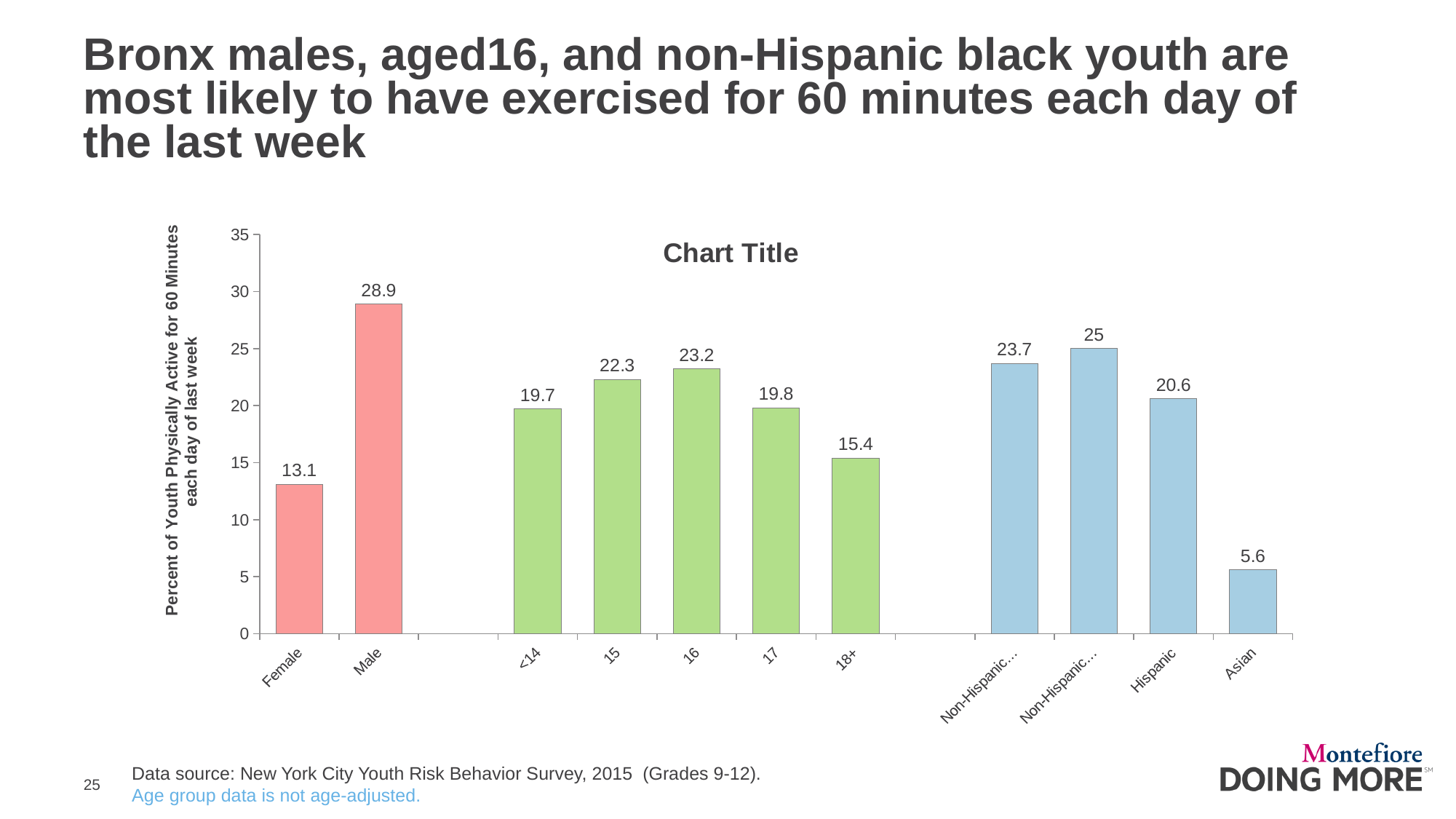
What is the value for Male? 28.9 What is the value for Female? 13.1 What is the value for the 16 age group? 23.2 How many bars are plotted in the chart? 11 What is the label on the vertical axis? Percent of Youth Physically Active for 60 Minutes each day of last week What is the value for Asian? 5.6 Which is larger, the value for 15 or the value for 17? 15 What kind of chart is shown? Bar chart What is the value for Hispanic? 20.6 Which category has the highest value? Male What is the difference between the values for Male and Female? 15.8 Which category has the lowest value? Asian